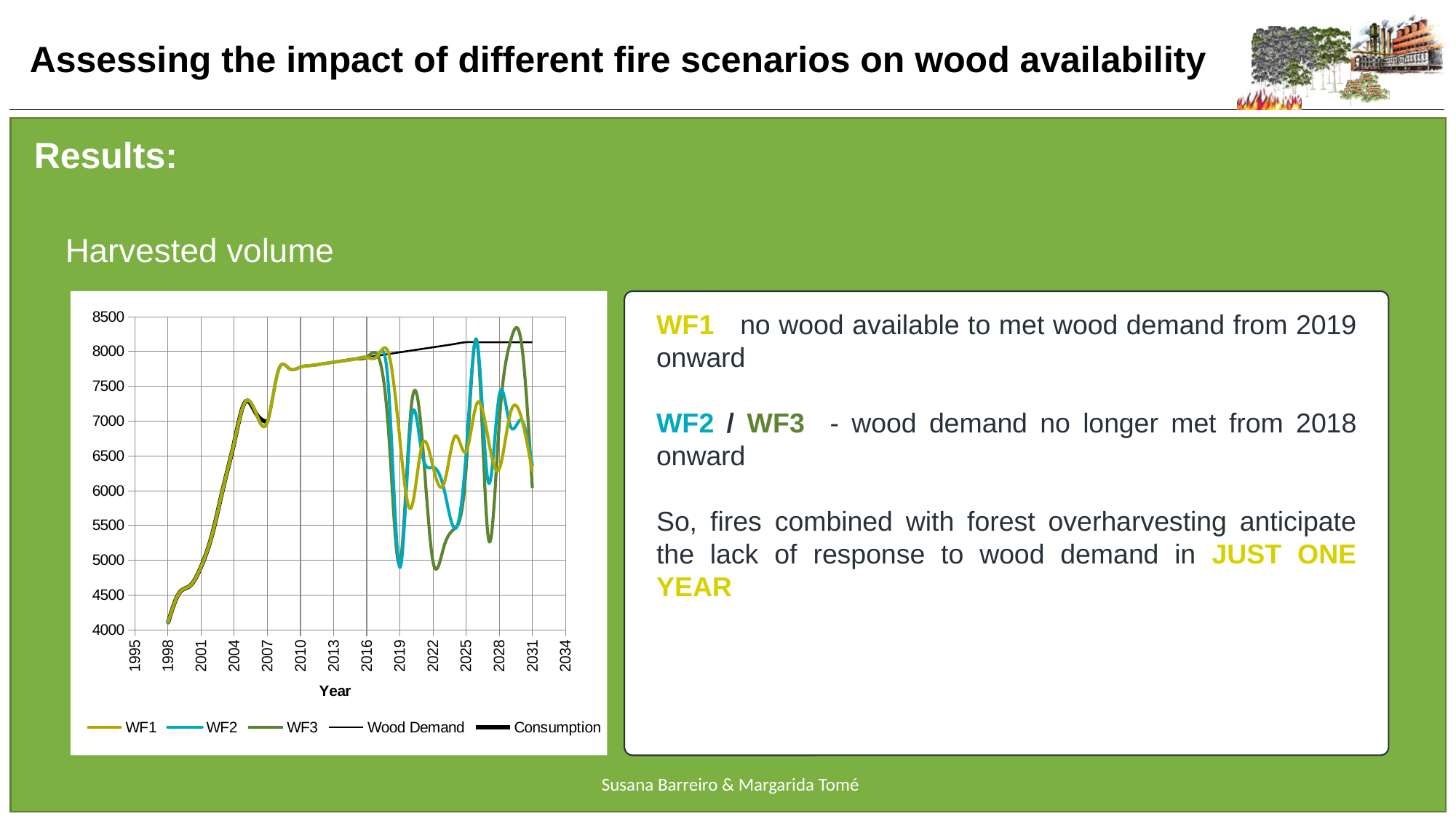
Do the harvested volume values rise or fall between 1998 and 2016? rise Is the harvested volume around 2010 greater or less than 7500? greater What is the title of the x axis of the chart? Year Is the peak value of WF3 around 2028 greater or less than 8000? greater Is the harvested volume for WF2 in 2019 greater or less than 5500? less How many series does the chart legend list? 5 What kind of chart is shown on the slide? line chart What is the highest value shown on the y axis of the chart? 8500 Which series are listed in the chart legend? WF1, WF2, WF3, Wood Demand, Consumption